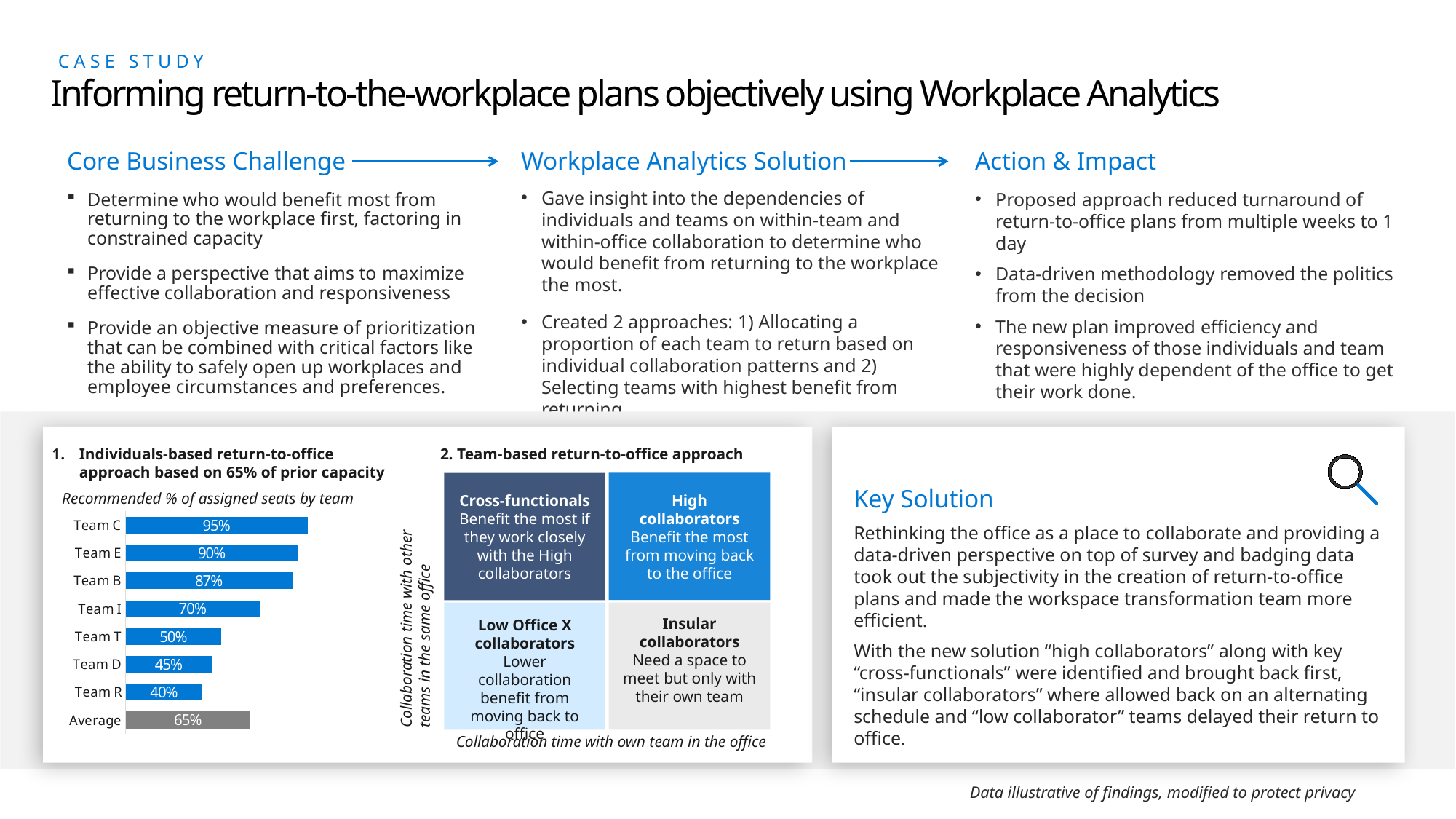
What is the recommended % of assigned seats for Team T? 50% Which has a higher recommended % of assigned seats, Team D or Team I? Team I Do the team values rise or fall going from the top bar (Team C) down to Team R? Fall What kind of chart is used to show the recommended % of assigned seats by team? Bar chart Which team has the lowest recommended % of assigned seats? Team R Which team has the highest recommended % of assigned seats? Team C What is the difference between the values for Team E and Team I? 20% How many teams (excluding the Average bar) are shown in the bar chart? 7 What colour is the Average bar in the chart, compared with the blue team bars? Grey What is the Average value shown in the bar chart? 65% What is the difference between the recommended % of assigned seats for Team C and Team R? 55% What is the recommended % of assigned seats for Team B? 87%